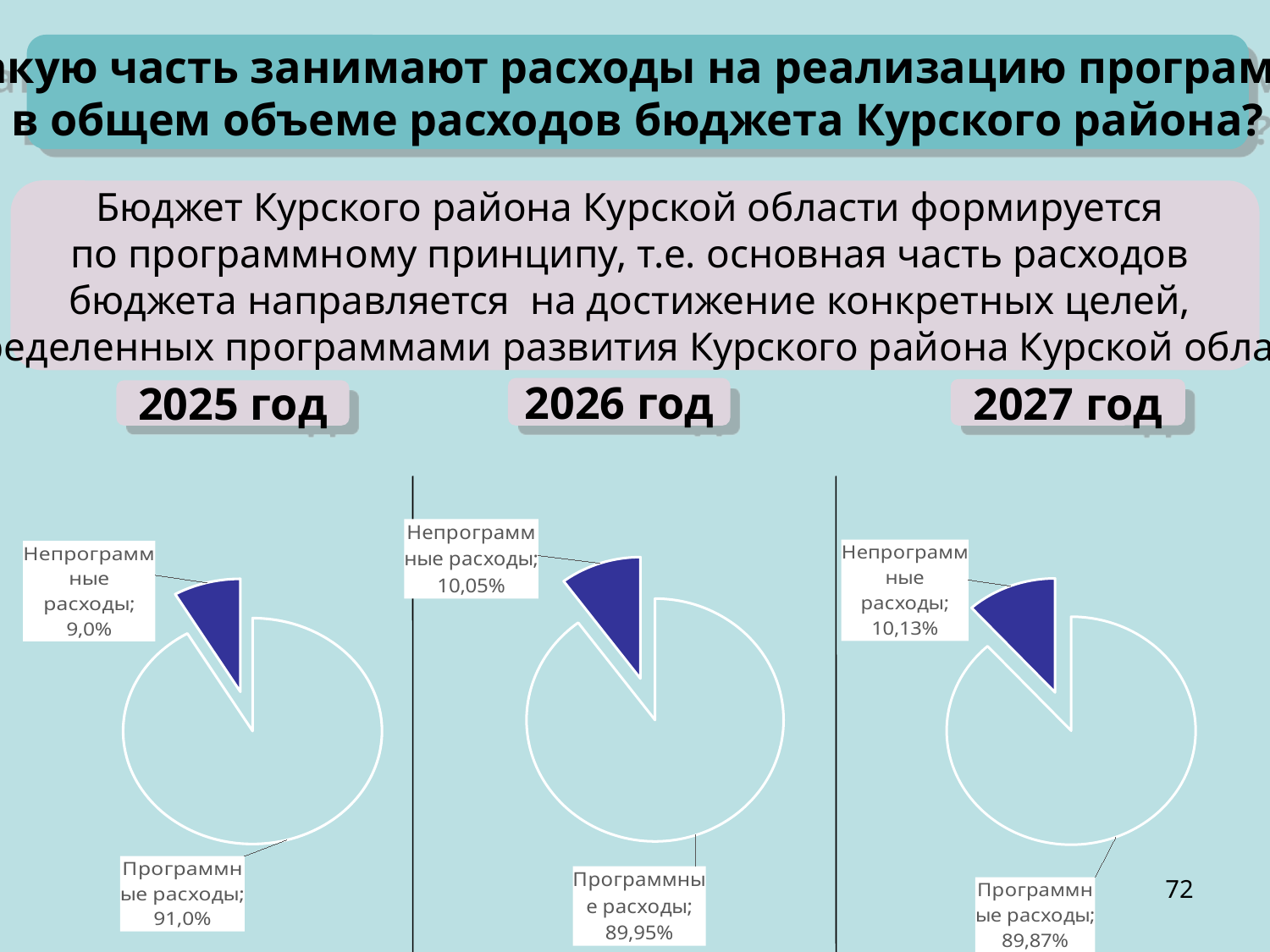
How many categories does the 2026 год pie chart show? 2 In the 2027 год pie chart, which category has the largest share? Программные расходы In the 2026 год pie chart, which category has the smallest share? Непрограммные расходы What type of chart is used for the 2025 год data? Pie chart In the 2027 год pie chart, what share do Программные расходы have? 89,87% In the 2025 год pie chart, what share do Непрограммные расходы have? 9,0% In the 2025 год pie chart, what is the difference between the shares of Программные расходы and Непрограммные расходы? 82,0% In the 2027 год pie chart, what share do Непрограммные расходы have? 10,13% How many pie charts are shown on the slide? 3 In the 2026 год pie chart, what share do Непрограммные расходы have? 10,05% In the 2026 год pie chart, what share do Программные расходы have? 89,95% In the 2025 год pie chart, what share do Программные расходы have? 91,0%